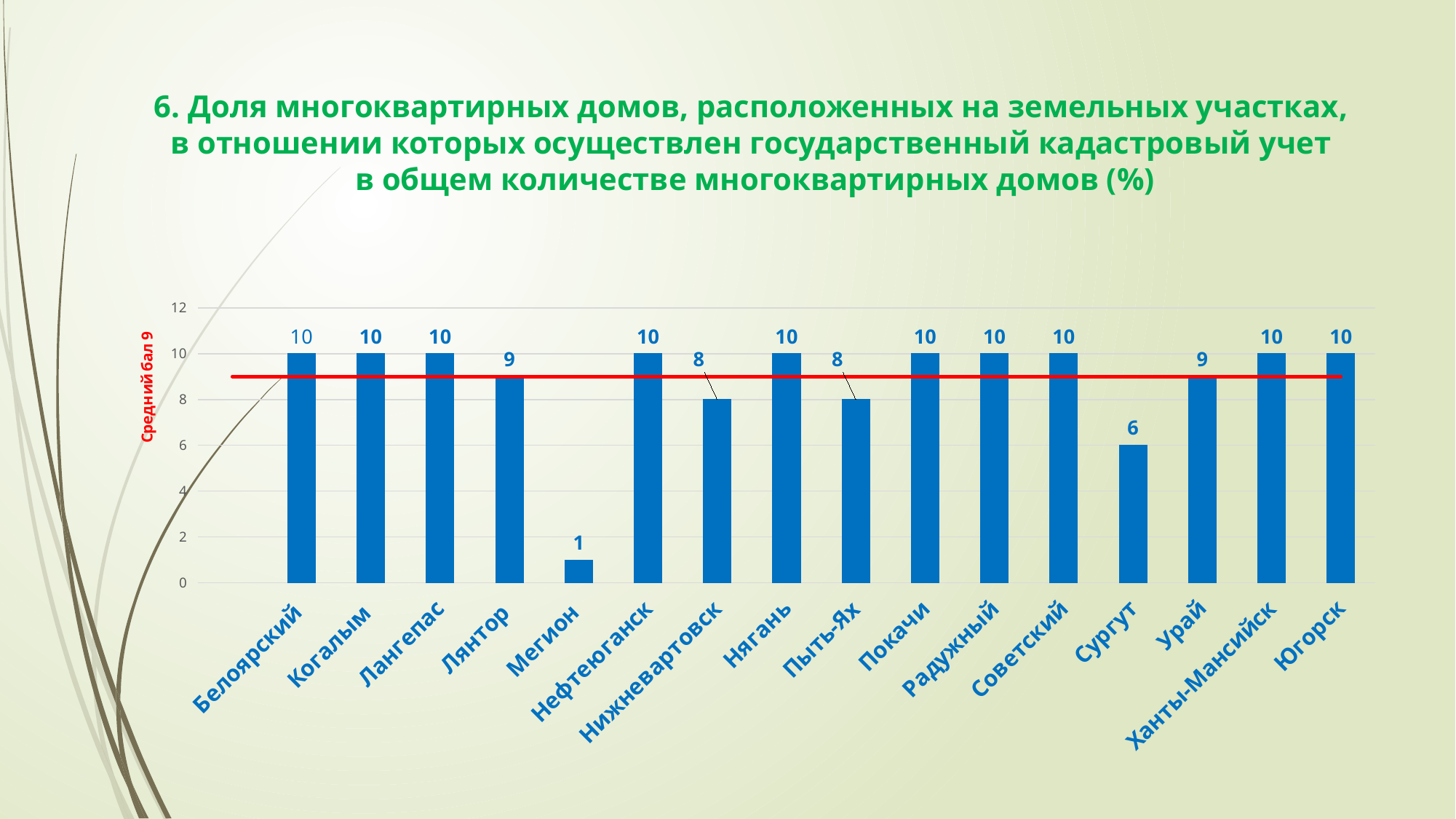
Is the value for Сургут greater or less than 8? less What kind of chart is shown on the slide? bar chart What is the value for Сургут? 6 Which category has the lowest value? Мегион What is the value for Урай? 9 What is the value for Нижневартовск? 8 What is the difference between the values for Лянтор and Мегион? 8 What is the difference between the values for Когалым and Сургут? 4 What is the value for Мегион? 1 How many categories are shown on the x axis? 16 Which is larger, the value for Пыть-Ях or the value for Сургут? Пыть-Ях What does the red horizontal line across the chart represent, according to its label? Средний бал 9